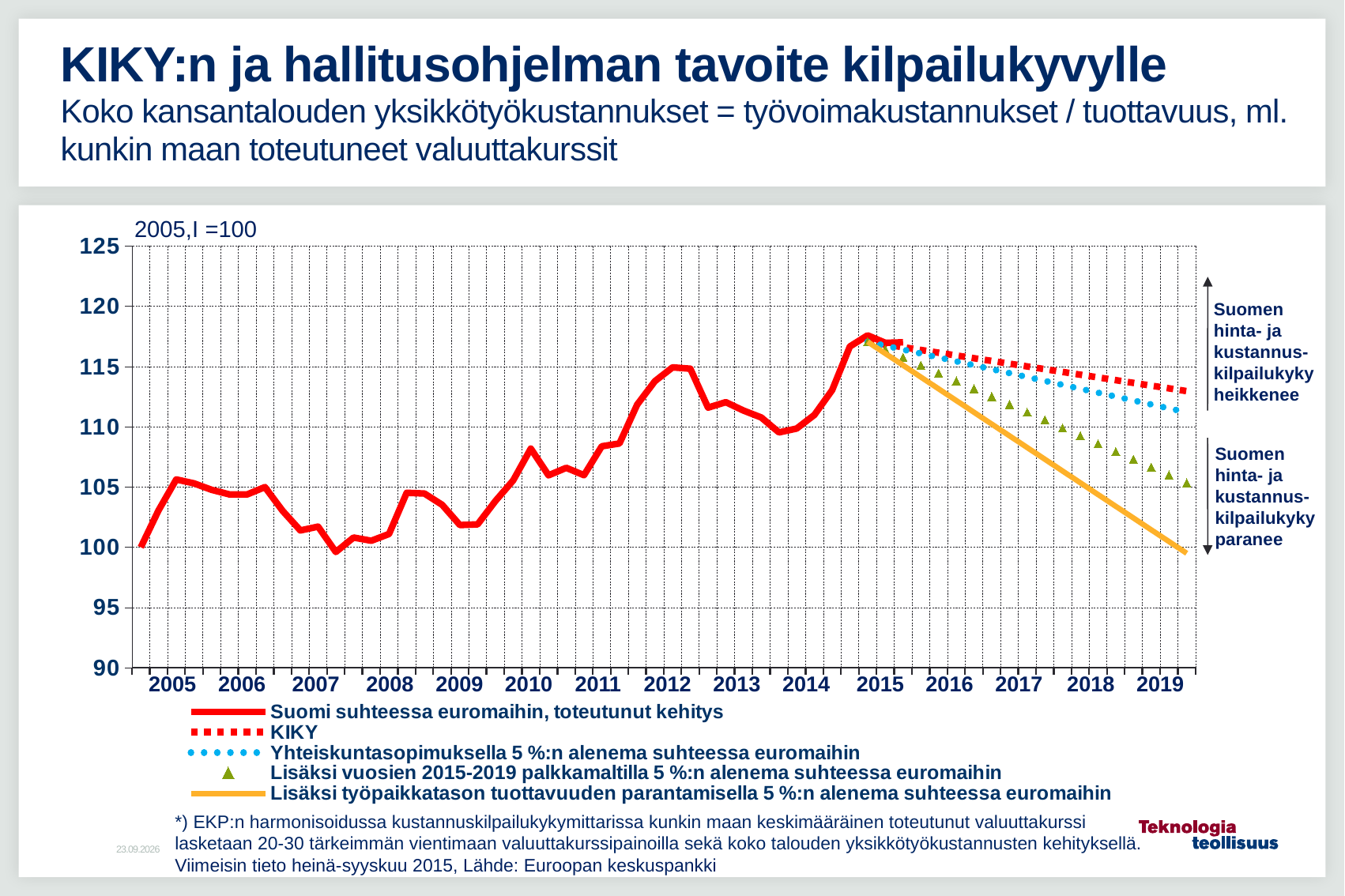
Is the value of the green triangle series at the end of 2019 greater or less than 110? less How many series does the legend list? 5 What kind of chart is shown on the slide? line chart How many years are labelled on the x axis? 15 Which series has the lowest value at the end of 2019? Lisäksi työpaikkatason tuottavuuden parantamisella 5 %:n alenema suhteessa euromaihin Does the orange line rise or fall from 2015 to 2019? fall What is the value of the red solid line (Suomi suhteessa euromaihin, toteutunut kehitys) at the start of 2005? 100 What base index note is printed above the y axis? 2005,I =100 Which series has the highest value at the end of 2019? KIKY Is the value of the orange line at the end of 2019 greater or less than 105? less Is the value of the blue dotted line at the end of 2019 greater or less than 110? greater